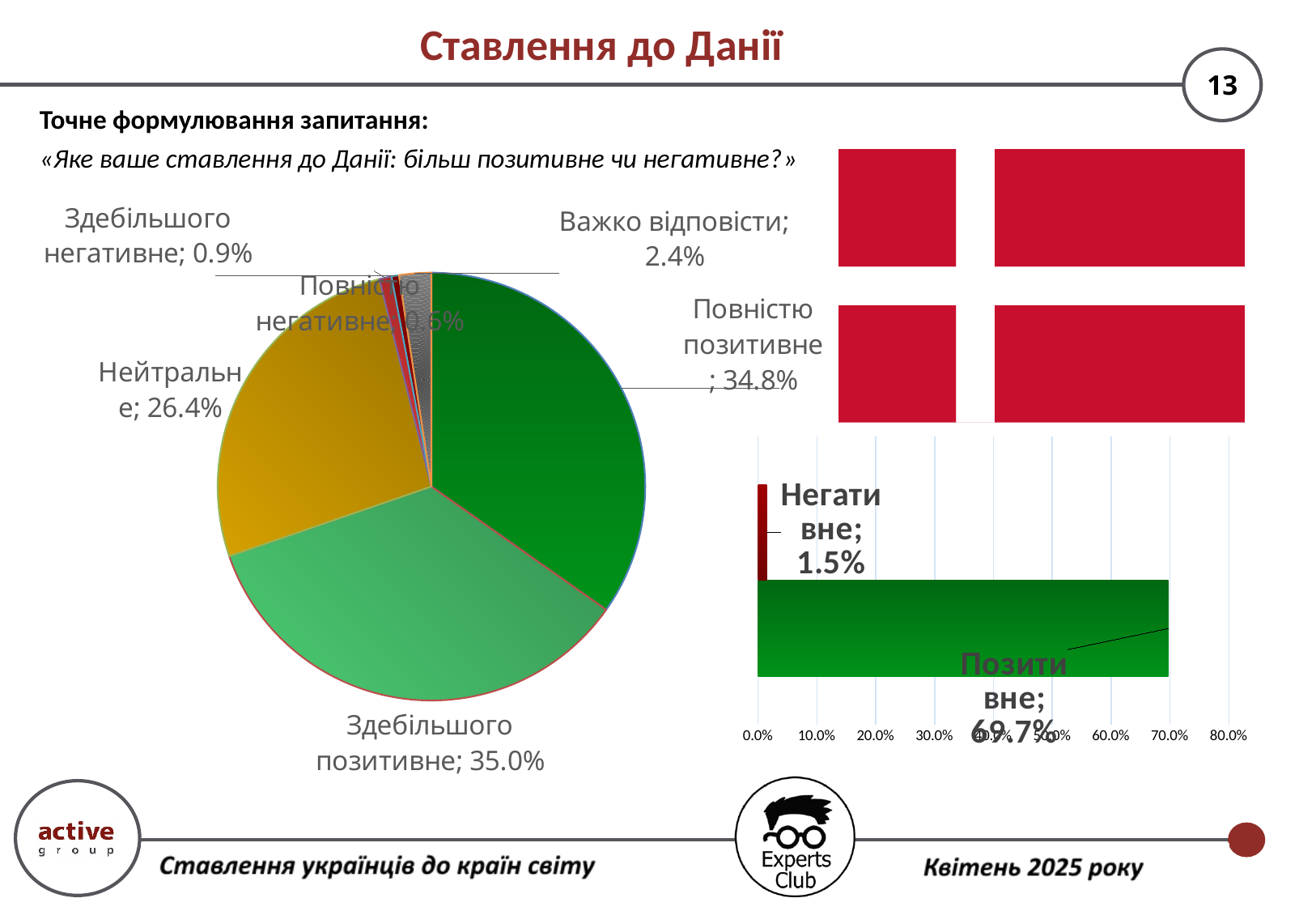
What kind of chart is the chart on the left of the slide? Pie chart In the pie chart, which is larger: «Нейтральне» or «Здебільшого негативне»? Нейтральне In the pie chart, what is the value for «Нейтральне»? 26.4% In the bar chart at the bottom right, what is the difference between «Позитивне» and «Негативне»? 68.2% In the bar chart at the bottom right, what is the value for «Позитивне»? 69.7% In the pie chart, what is the value for «Здебільшого позитивне»? 35.0% How many slices does the pie chart have? 6 In the pie chart, which category has the largest share? Здебільшого позитивне In the pie chart, what is the value for «Важко відповісти»? 2.4% In the bar chart at the bottom right, what is the value for «Негативне»? 1.5% In the pie chart, what is the value for «Повністю позитивне»? 34.8% In the pie chart, what is the difference between «Здебільшого позитивне» and «Нейтральне»? 8.6%